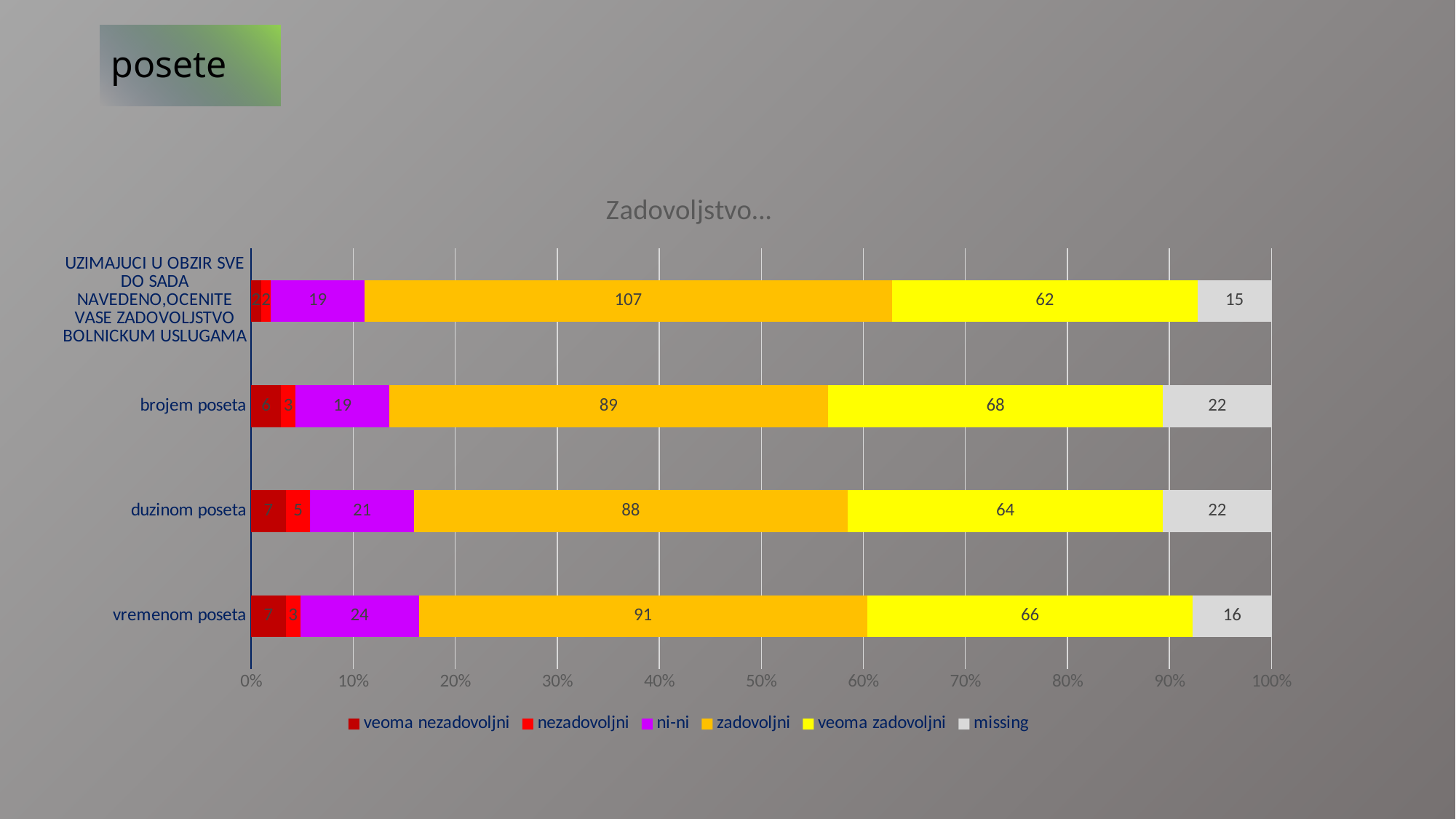
How many series does the legend list? 6 What is the total of all segments in the 'brojem poseta' bar? 207 Which category has the highest 'zadovoljni' value? UZIMAJUCI U OBZIR SVE DO SADA NAVEDENO, OCENITE VASE ZADOVOLJSTVO BOLNICKUM USLUGAMA Which category has the lowest 'missing' value? UZIMAJUCI U OBZIR SVE DO SADA NAVEDENO, OCENITE VASE ZADOVOLJSTVO BOLNICKUM USLUGAMA What is the value of the 'ni-ni' segment for the category 'UZIMAJUCI U OBZIR SVE DO SADA NAVEDENO, OCENITE VASE ZADOVOLJSTVO BOLNICKUM USLUGAMA'? 19 Which has the larger 'ni-ni' value, 'vremenom poseta' or 'duzinom poseta'? vremenom poseta How many categories are shown on the chart? 4 What is the value of the 'missing' segment for 'duzinom poseta'? 22 What is the value of the 'zadovoljni' segment for 'brojem poseta'? 89 What is the difference between the 'veoma zadovoljni' values for 'brojem poseta' and 'duzinom poseta'? 4 What kind of chart is shown on the slide? Stacked bar chart What is the value of the 'veoma zadovoljni' segment for 'vremenom poseta'? 66